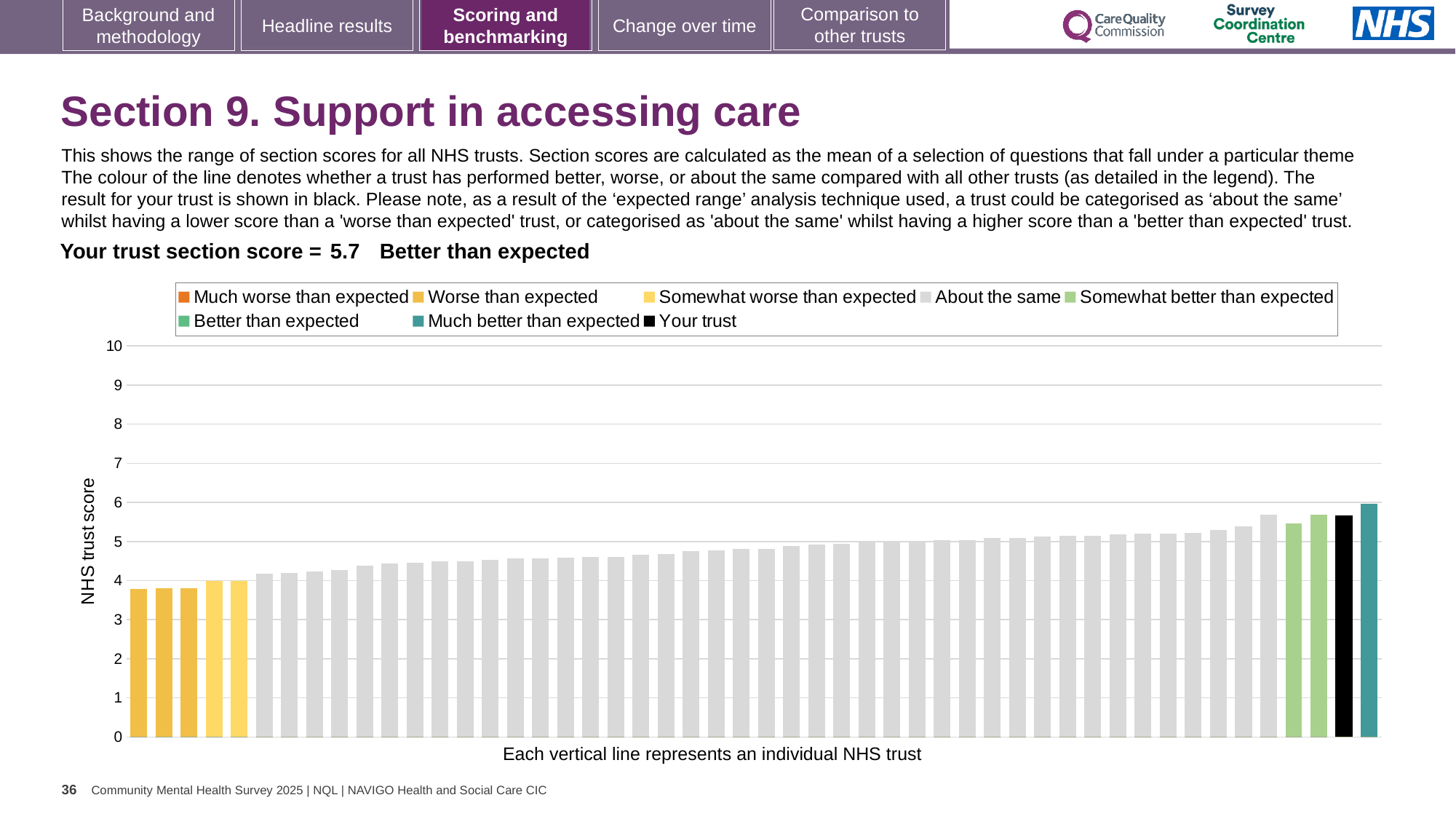
What colour is the bar for your trust in the chart? black Do the bar values rise or fall from left to right along the x axis? rise Is the value of the lowest bar in the chart greater or less than 5? less Which legend category does the tallest bar in the chart belong to? Much better than expected What is the section score for your trust? 5.7 How many bars are coloured as 'Somewhat better than expected'? 2 How is your trust categorised for this section? Better than expected Which is higher: the black bar for your trust or the teal 'Much better than expected' bar at the far right? the teal 'Much better than expected' bar Is the value for your trust (the black bar) greater or less than 5? greater How many categories does the chart legend list? 8 What kind of chart is shown on the slide? bar chart What is the label on the vertical axis of the chart? NHS trust score